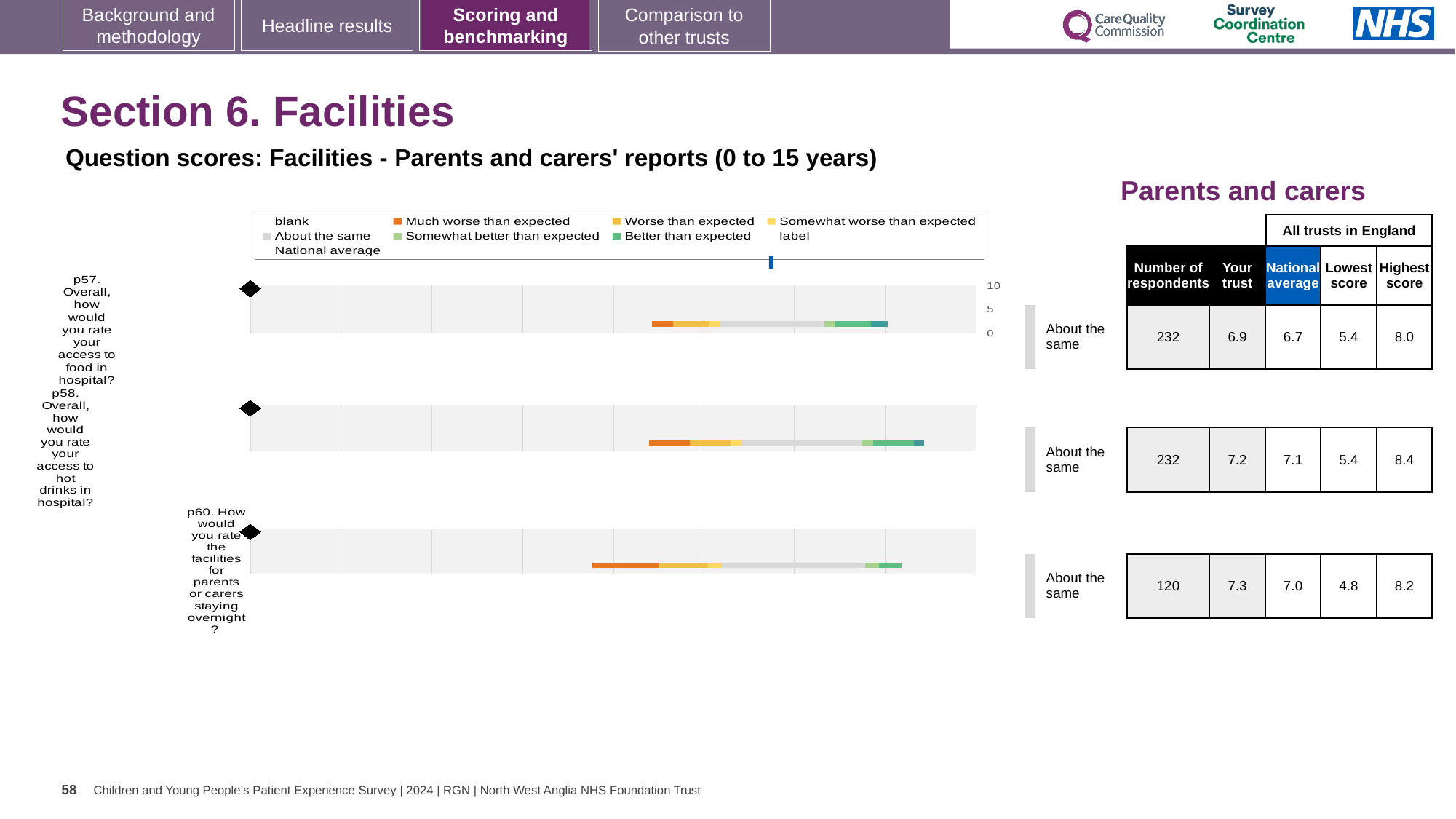
Which question has the lowest 'Lowest score' among all trusts in England? p60 (facilities for parents or carers staying overnight) What is the highest score across all trusts in England for p58 (access to hot drinks in hospital)? 8.4 How many respondents answered p60 (How would you rate the facilities for parents or carers staying overnight?)? 120 Which question has the highest 'Your trust' score? p60 (facilities for parents or carers staying overnight) What is the maximum value shown on the chart axis? 10 How many questions are plotted on the slide? 3 What benchmark category is shown for all three questions? About the same What is the difference between the 'Your trust' score and the national average for p60 (facilities for parents or carers staying overnight)? 0.3 What is the 'Your trust' score for p57 (Overall, how would you rate your access to food in hospital?)? 6.9 What kind of chart is used to show the question scores? bar chart What is the national average score for p58 (Overall, how would you rate your access to hot drinks in hospital?)? 7.1 For p57 (access to food in hospital), is the 'Your trust' score higher or lower than the national average? higher